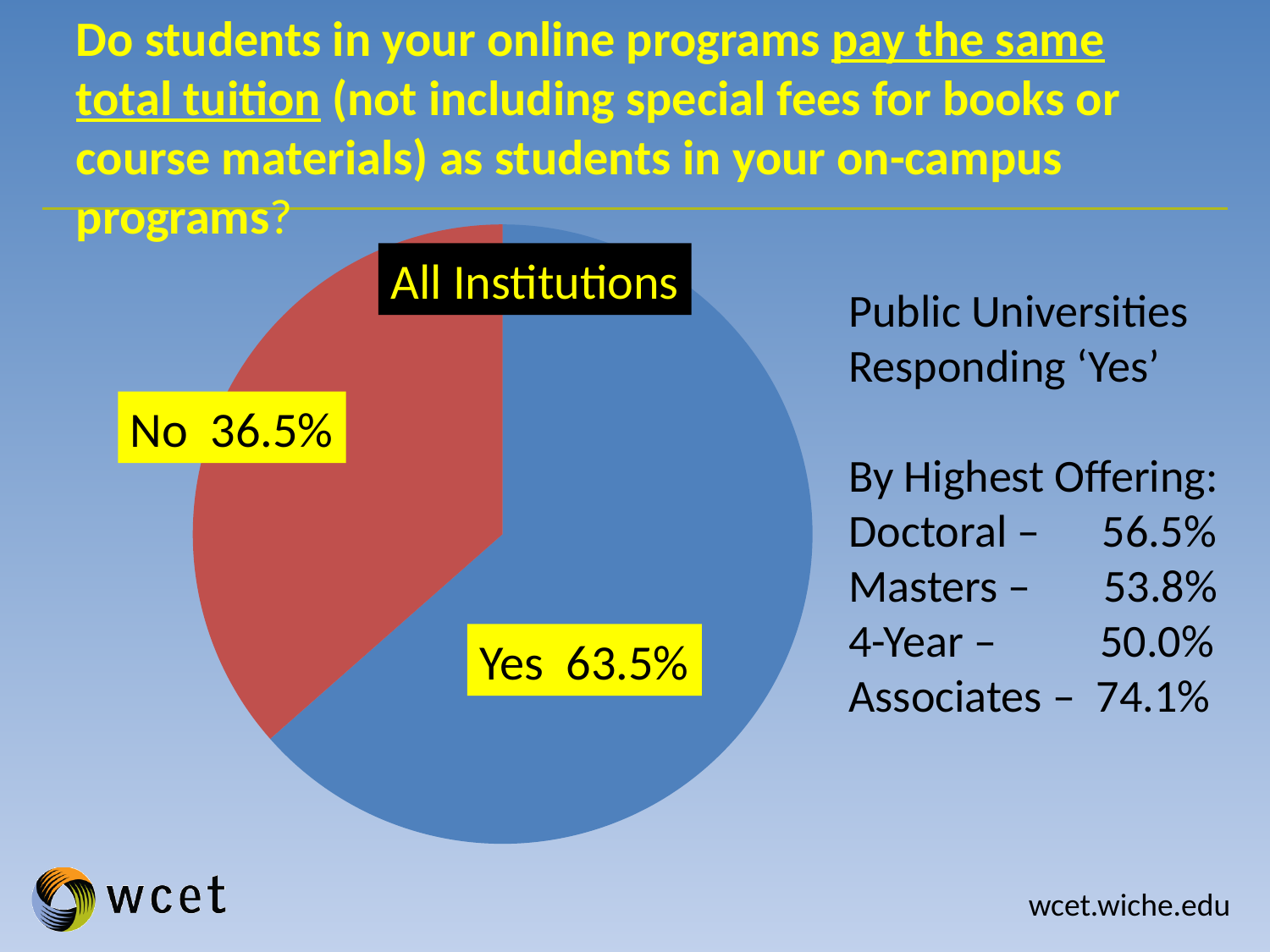
What colour is the Yes slice of the pie chart? blue What percentage of all institutions responded 'No'? 36.5% What share of the pie does the Yes slice represent? 63.5% What kind of chart is shown on the slide? pie chart What percentage of all institutions responded 'Yes'? 63.5% What is the difference in percentage points between the Yes and No slices? 27 percentage points Is the share of the No slice greater or less than 50%? less Which slice of the pie is the largest? Yes What is the label shown in the black box above the pie chart? All Institutions Which slice of the pie is the smallest? No How many slices does the pie chart have? 2 Which response has the larger share of the pie, Yes or No? Yes